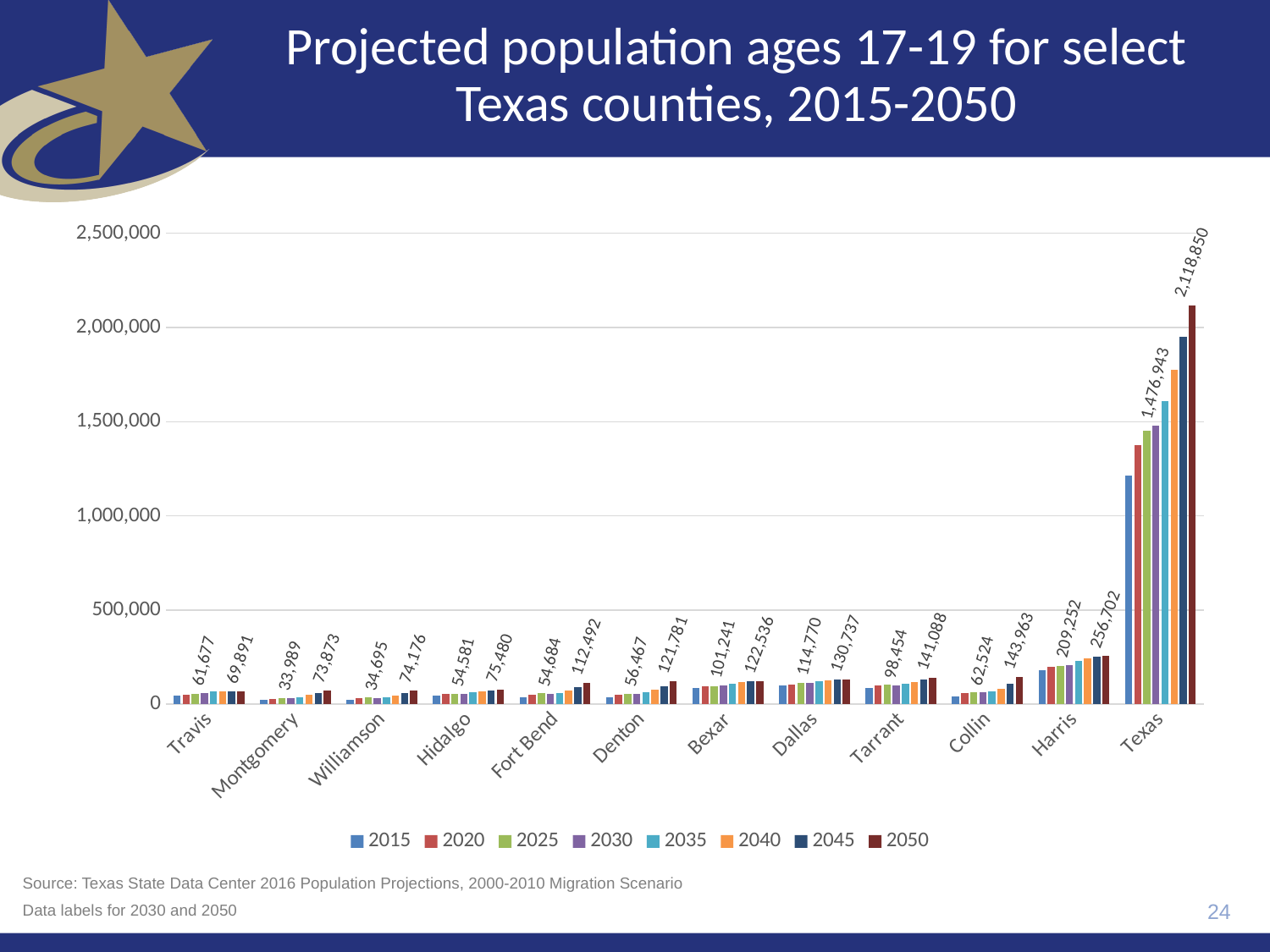
How many series does the legend list? 8 How many counties or regions are shown on the x axis? 12 What is the difference between the 2050 and 2030 projected populations ages 17-19 for Fort Bend county? 57,808 What is the projected 2050 population ages 17-19 for Collin county? 143,963 What kind of chart is shown on the slide? Bar chart Among the counties (excluding the Texas total), which has the highest projected 2050 population ages 17-19? Harris Which is larger: the 2050 projected population ages 17-19 for Tarrant or for Dallas? Tarrant What is the projected 2030 population ages 17-19 for Montgomery county? 33,989 What is the projected 2050 population ages 17-19 for Texas? 2,118,850 Is the 2015 value for Texas greater or less than 1,000,000? greater Which category has the lowest projected 2030 population ages 17-19? Montgomery What is the projected 2030 population ages 17-19 for Harris county? 209,252